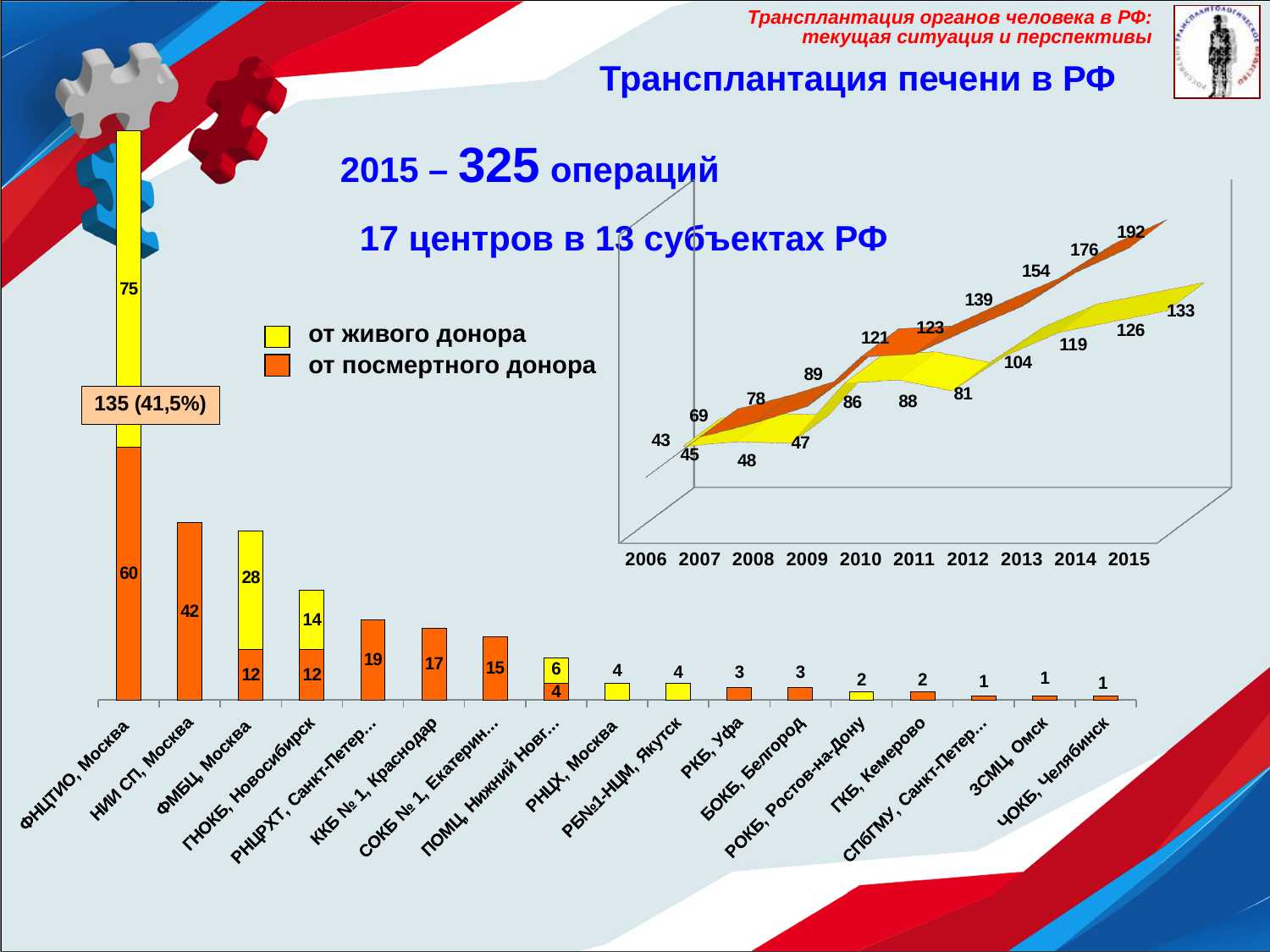
In the bar chart on the left, what is the difference between the living-donor values of ФМБЦ, Москва and ГНОКБ, Новосибирск? 14 In the area chart on the right, do the values of the orange series rise or fall from 2006 to 2015? rise In the bar chart on the left, what is the value from a living donor (от живого донора) for ФНЦТИО, Москва? 75 In the bar chart on the left, how many centers are shown on the x axis? 17 In the area chart on the right, what is the value of the orange series in 2015? 192 In the bar chart on the left, which is larger: the value for РНЦРХТ, Санкт-Петер... or the value for ККБ № 1, Краснодар? РНЦРХТ, Санкт-Петер... In the bar chart on the left, how many series does the legend list? 2 In the bar chart on the left, what is the total of the stacked bar for ФМБЦ, Москва? 40 In the bar chart on the left, what is the total shown for the ФНЦТИО, Москва bar? 135 (41,5%) In the bar chart on the left, which center has the highest total? ФНЦТИО, Москва In the bar chart on the left, what is the value from a deceased donor (от посмертного донора) for ФНЦТИО, Москва? 60 In the bar chart on the left, what is the value for НИИ СП, Москва? 42